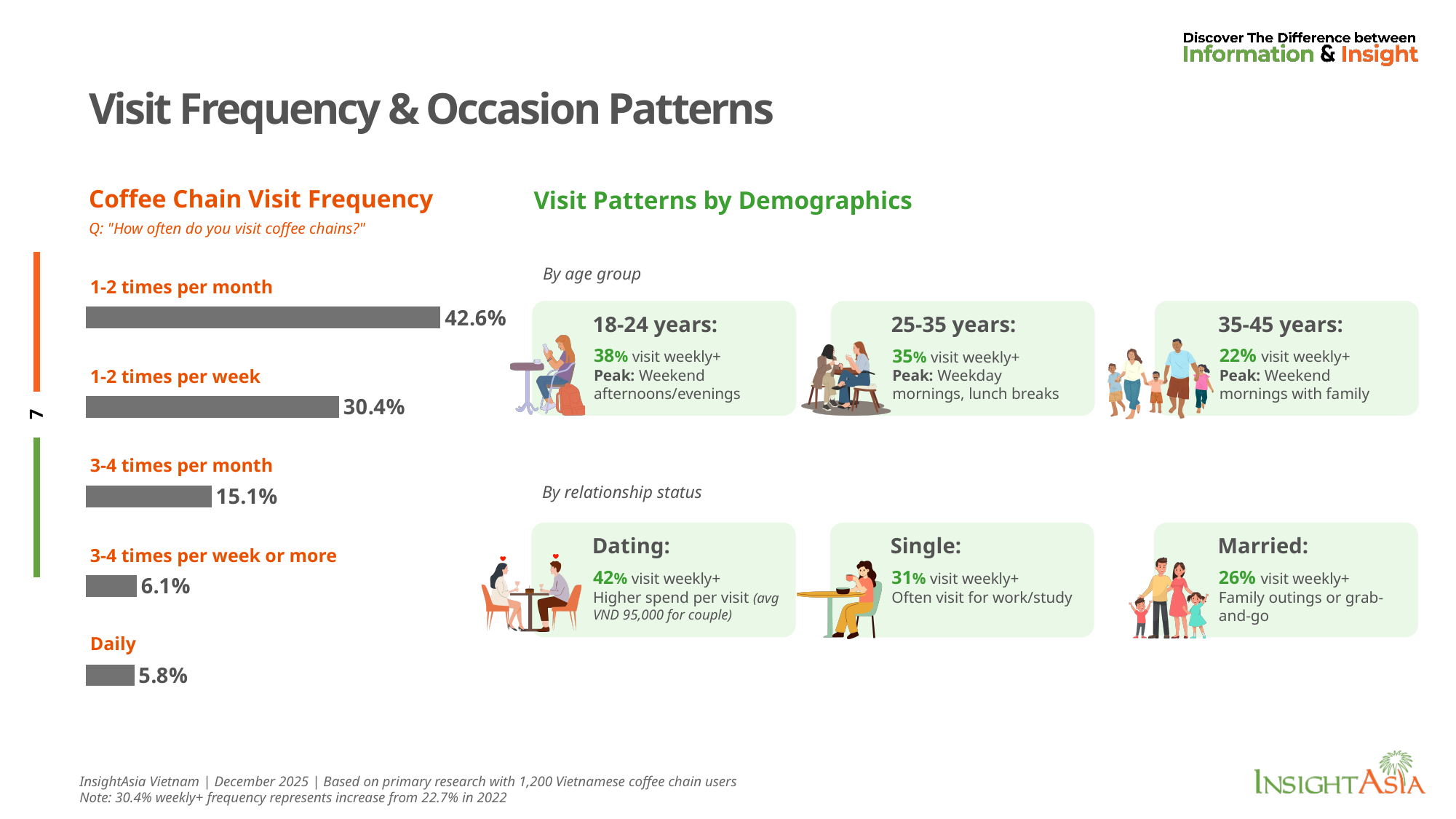
In the Coffee Chain Visit Frequency chart, what percentage of respondents visit 1-2 times per month? 42.6% In the Coffee Chain Visit Frequency chart, what is the value for Daily? 5.8% In the Coffee Chain Visit Frequency chart, what is the difference between the values for 3-4 times per week or more and Daily? 0.3 percentage points In the Coffee Chain Visit Frequency chart, what is the difference between the values for 1-2 times per month and 1-2 times per week? 12.2 percentage points In the Coffee Chain Visit Frequency chart, which is larger: 1-2 times per week or 3-4 times per month? 1-2 times per week In the Coffee Chain Visit Frequency chart, what is the value for 3-4 times per week or more? 6.1% What kind of chart is the Coffee Chain Visit Frequency chart? Bar chart What survey question is shown beneath the Coffee Chain Visit Frequency chart title? How often do you visit coffee chains? In the Coffee Chain Visit Frequency chart, what is the value for 3-4 times per month? 15.1% In the Coffee Chain Visit Frequency chart, which visit frequency has the highest value? 1-2 times per month How many visit frequency categories are shown in the Coffee Chain Visit Frequency chart? 5 In the Coffee Chain Visit Frequency chart, which visit frequency has the lowest value? Daily